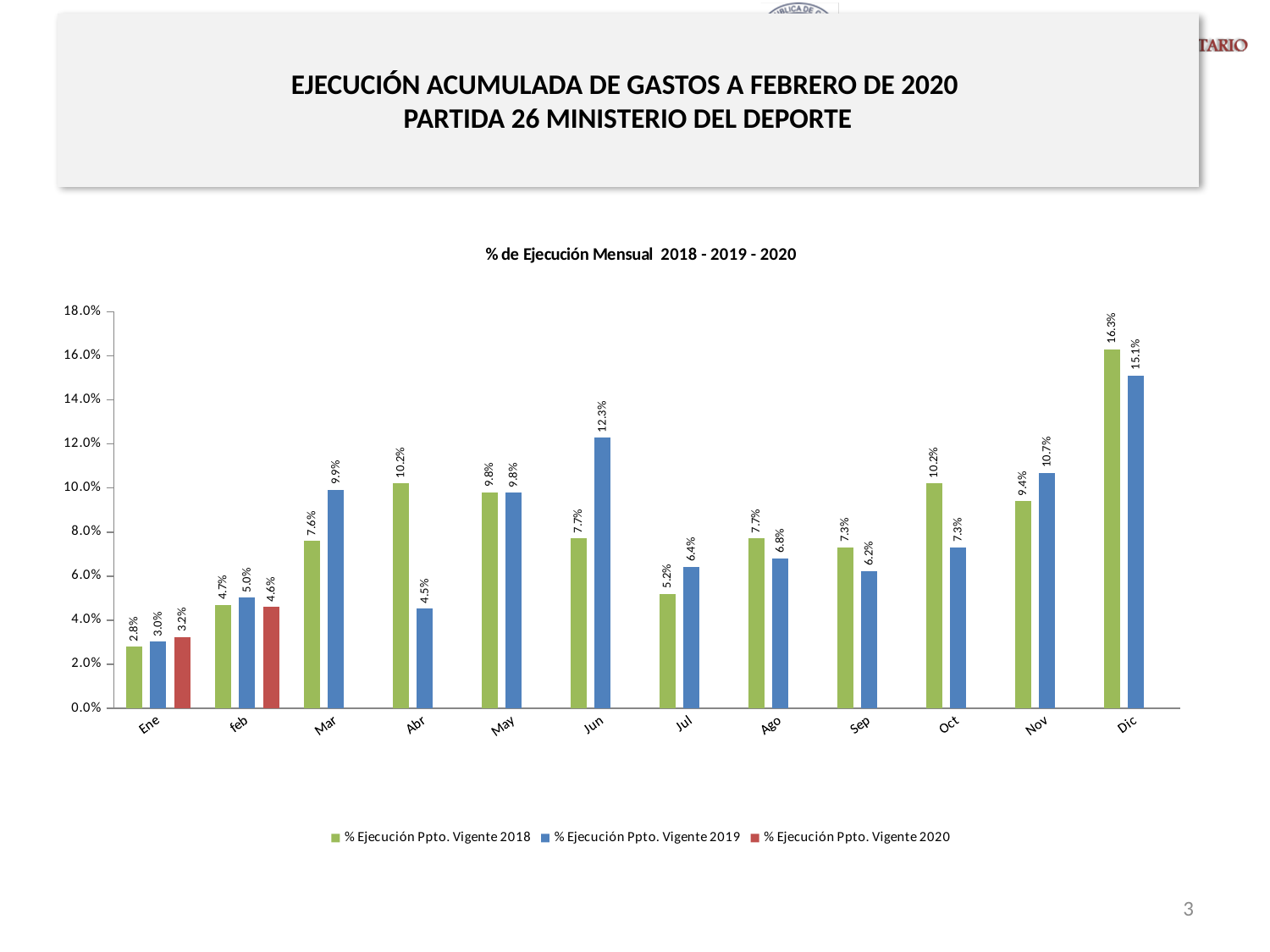
What is the difference between the 2018 and 2019 values in Abr? 5.7% Which month has the lowest value for % Ejecución Ppto. Vigente 2018? Ene How many months are shown on the x axis? 12 How many series does the legend list? 3 What is the value for % Ejecución Ppto. Vigente 2019 in Jun? 12.3% Is the value for % Ejecución Ppto. Vigente 2019 in Nov greater or less than 10.0%? greater What is the value for % Ejecución Ppto. Vigente 2020 in Ene? 3.2% Which month has the highest value for % Ejecución Ppto. Vigente 2019? Dic Which is larger in Jul: the 2018 value or the 2019 value? 2019 What kind of chart is shown on the slide? bar chart What is the title of the chart? % de Ejecución Mensual 2018 - 2019 - 2020 What is the value for % Ejecución Ppto. Vigente 2018 in Dic? 16.3%